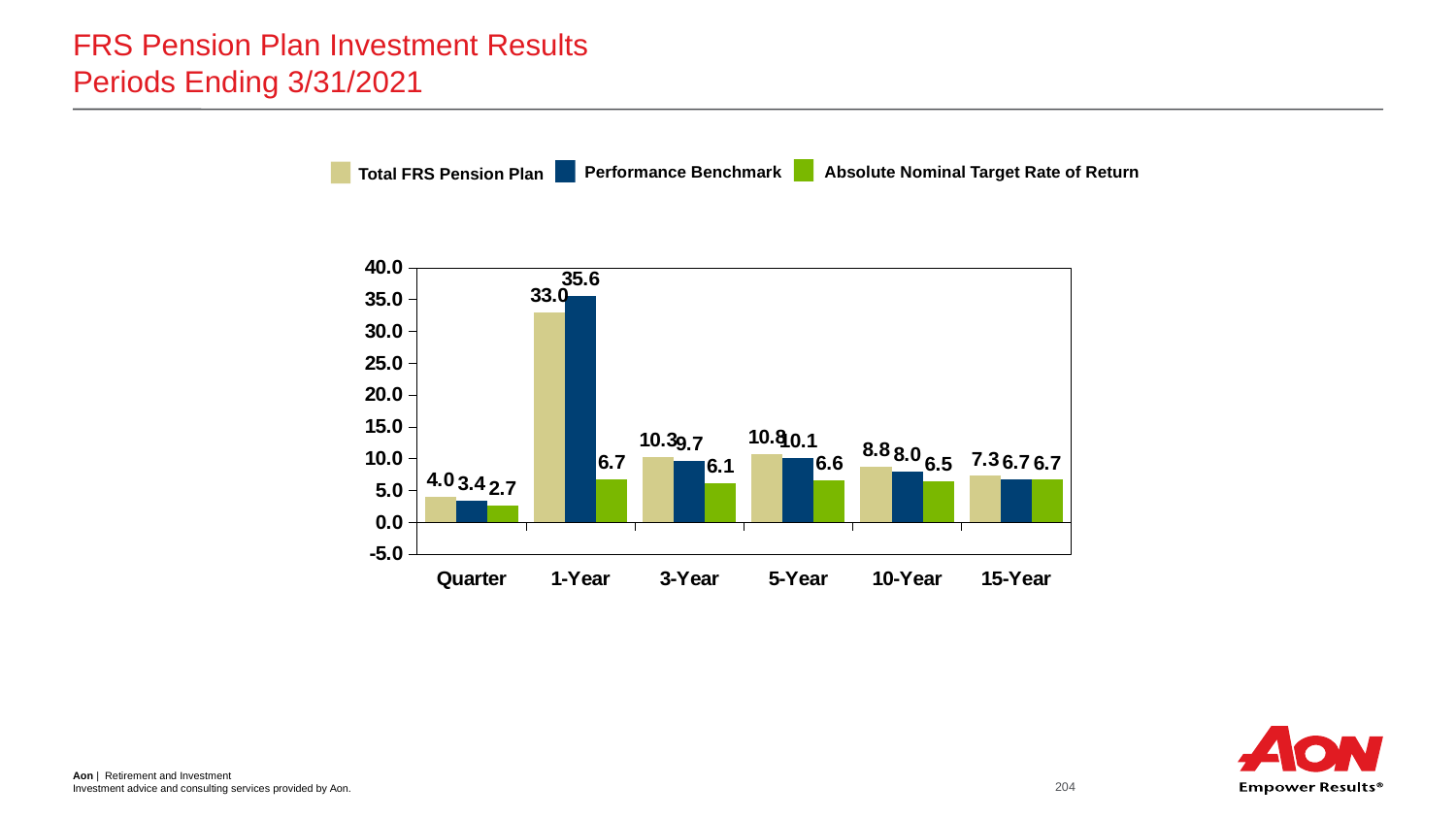
What is the Total FRS Pension Plan value for the Quarter period? 4.0 How many time periods are shown on the x axis? 6 How many series does the legend list? 3 What is the Performance Benchmark value for the 10-Year period? 8.0 What is the Absolute Nominal Target Rate of Return value for the 3-Year period? 6.1 For the 10-Year period, what is the difference between the Total FRS Pension Plan and the Absolute Nominal Target Rate of Return? 2.3 Which period has the highest Total FRS Pension Plan value? 1-Year What is the Performance Benchmark value for the 1-Year period? 35.6 What kind of chart is shown on the slide? Bar chart For the 1-Year period, how much higher is the Performance Benchmark than the Total FRS Pension Plan? 2.6 For the 3-Year period, which is larger: the Total FRS Pension Plan or the Performance Benchmark? Total FRS Pension Plan Which period has the lowest Absolute Nominal Target Rate of Return value? Quarter